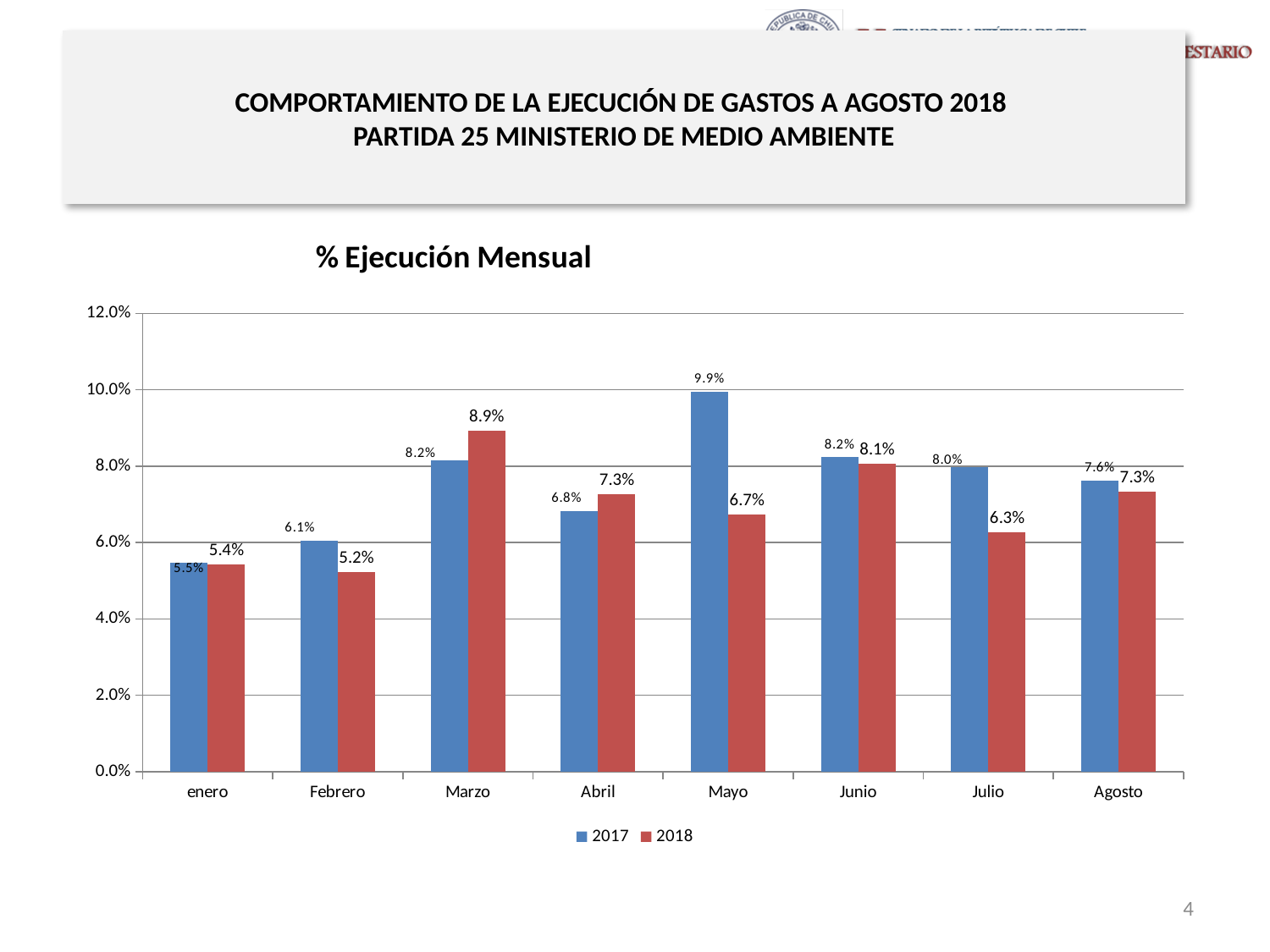
Is the value for 2017 in Mayo greater or less than 8.0%? greater How many series does the legend list? 2 Which month has the highest value for the 2017 series? Mayo What is the value for 2018 in Marzo? 8.9% What is the difference between the 2017 and 2018 values in Mayo? 3.2 percentage points What is the value for 2017 in Mayo? 9.9% What is the value for 2017 in Agosto? 7.6% What is the value for 2018 in Julio? 6.3% How many months are shown on the x axis? 8 In Marzo, which series has the larger value, 2017 or 2018? 2018 Which month has the lowest value for the 2018 series? Febrero What kind of chart is shown on the slide? Bar chart